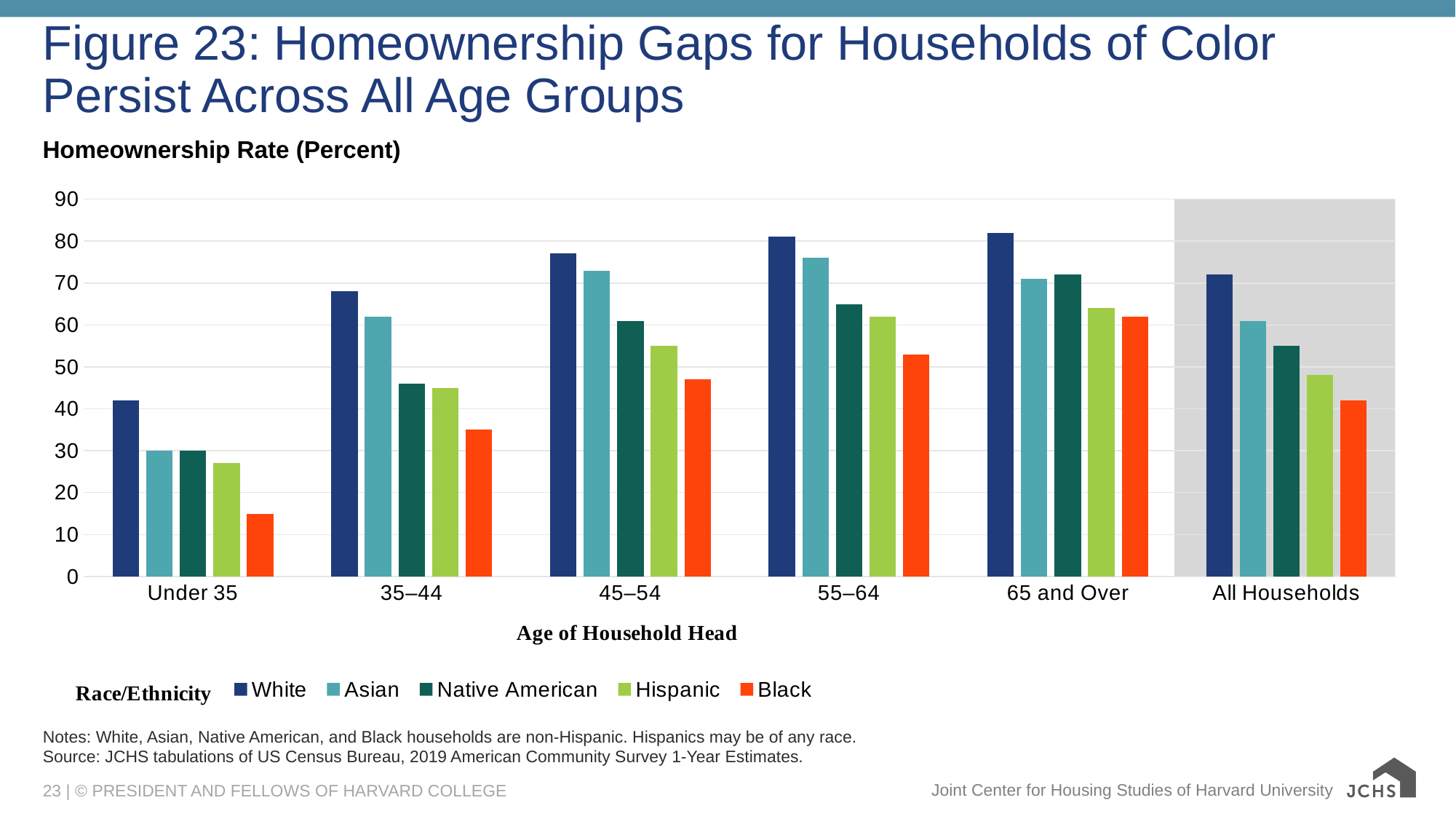
What is the title of the x axis? Age of Household Head Which is larger: the White homeownership rate for 35–44 or for 65 and Over? 65 and Over Does the White homeownership rate rise or fall from Under 35 to 65 and Over? Rises Which race/ethnicity has the lowest homeownership rate in the All Households group? Black What kind of chart is shown on the slide? Bar chart Is the homeownership rate for Black households Under 35 greater or less than 20? less How many race/ethnicity series does the legend list? 5 Is the homeownership rate for White households Under 35 greater or less than 40? greater How many age categories are shown on the x axis? 6 Is the homeownership rate for Hispanic households in the All Households group greater or less than 50? less Which race/ethnicity has the highest homeownership rate in the Under 35 group? White